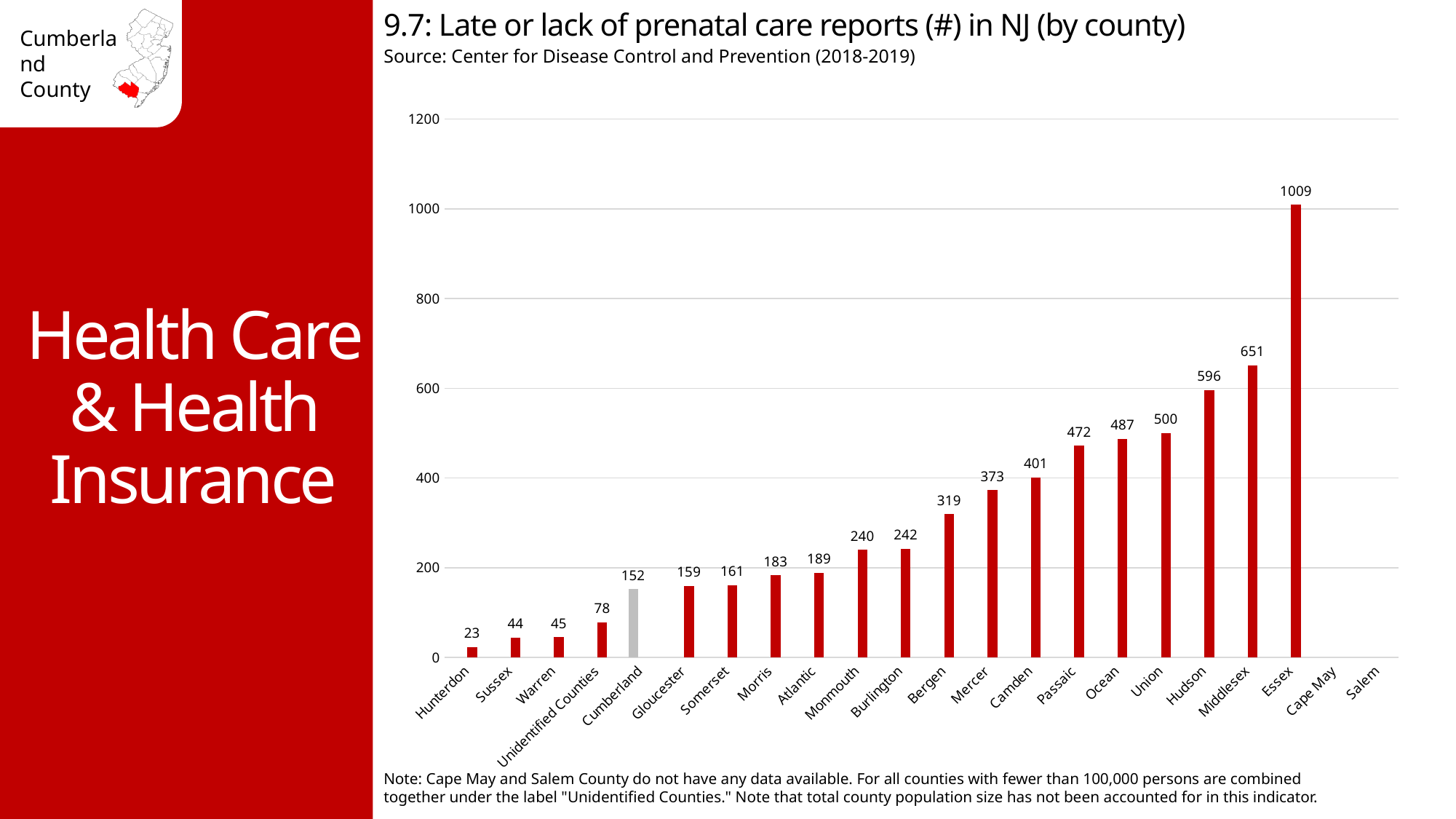
Is the value for Union greater or less than 400? greater How many county labels are shown on the x axis? 22 Which bar is shown in a different colour (grey) from the others? Cumberland What is the value shown for Essex County? 1009 What is the number of late or lack of prenatal care reports for Cumberland County? 152 Which has a higher value, Camden or Mercer? Camden Which county has the lowest number of late or lack of prenatal care reports among those with data? Hunterdon What is the difference between the values for Essex and Cumberland? 857 What is the difference between the values for Middlesex and Hudson? 55 Which county has the highest number of late or lack of prenatal care reports? Essex What kind of chart is shown on the slide? Bar chart What is the value shown for Bergen County? 319